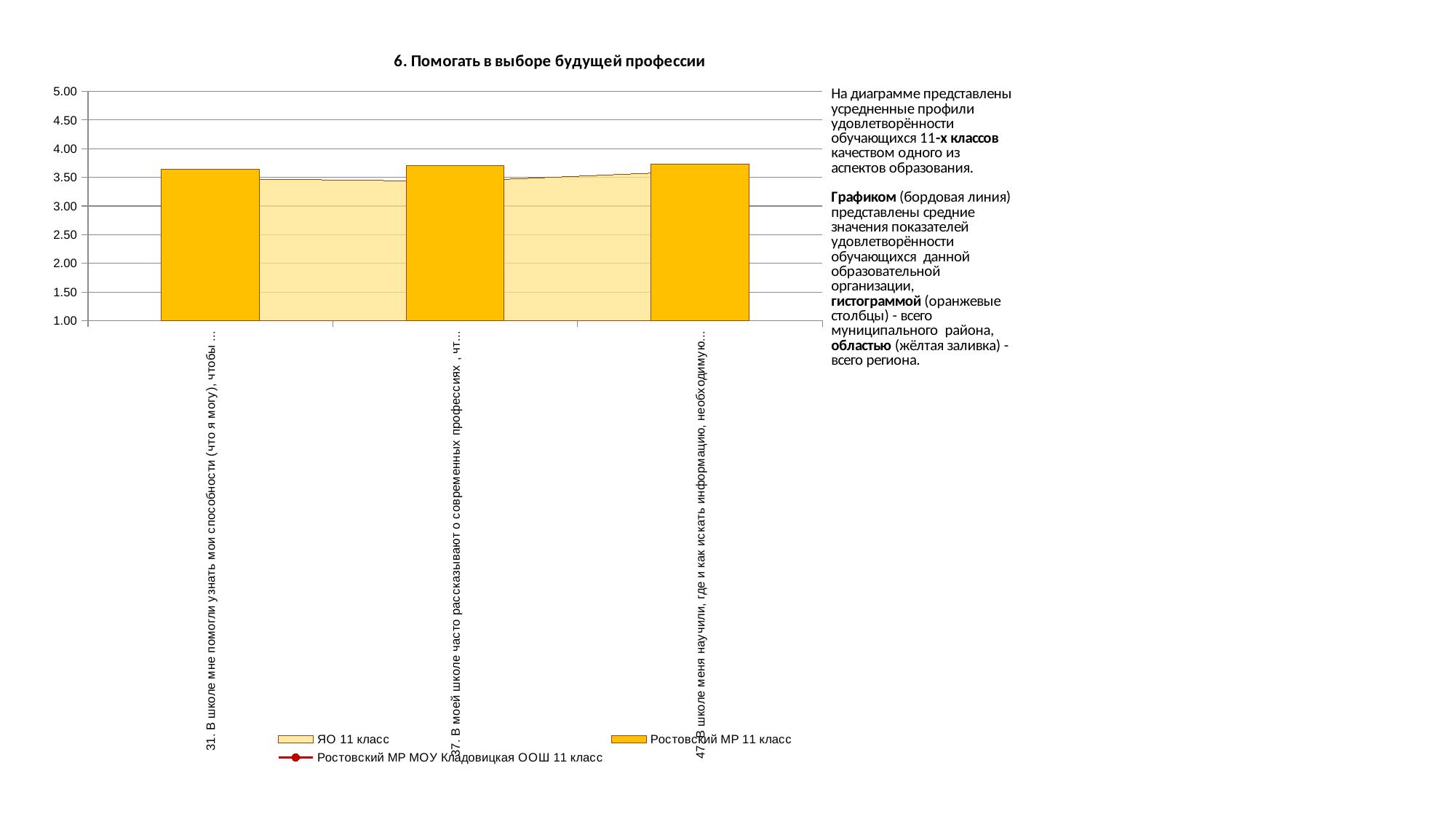
Is the 'ЯО 11 класс' value for question 31 greater or less than 3.00? greater How many categories (questions) are shown on the x axis? 3 For the series 'Ростовский МР 11 класс', which is larger: the value for question 31 or the value for question 47? question 47 Is the 'Ростовский МР 11 класс' value for question 31 greater or less than 3.50? greater Is the 'Ростовский МР 11 класс' value for question 37 greater or less than 3.50? greater For the series 'Ростовский МР 11 класс', which category has the lowest bar? 31. В школе мне помогли узнать мои способности (что я могу), чтобы ... What kind of chart is used for the series 'Ростовский МР 11 класс'? bar chart Which series is drawn as a line with markers? Ростовский МР МОУ Кладовицкая ООШ 11 класс What is the title of the chart? 6. Помогать в выборе будущей профессии How many series does the legend list? 3 Do the 'Ростовский МР 11 класс' bars rise or fall from left to right along the x axis? rise